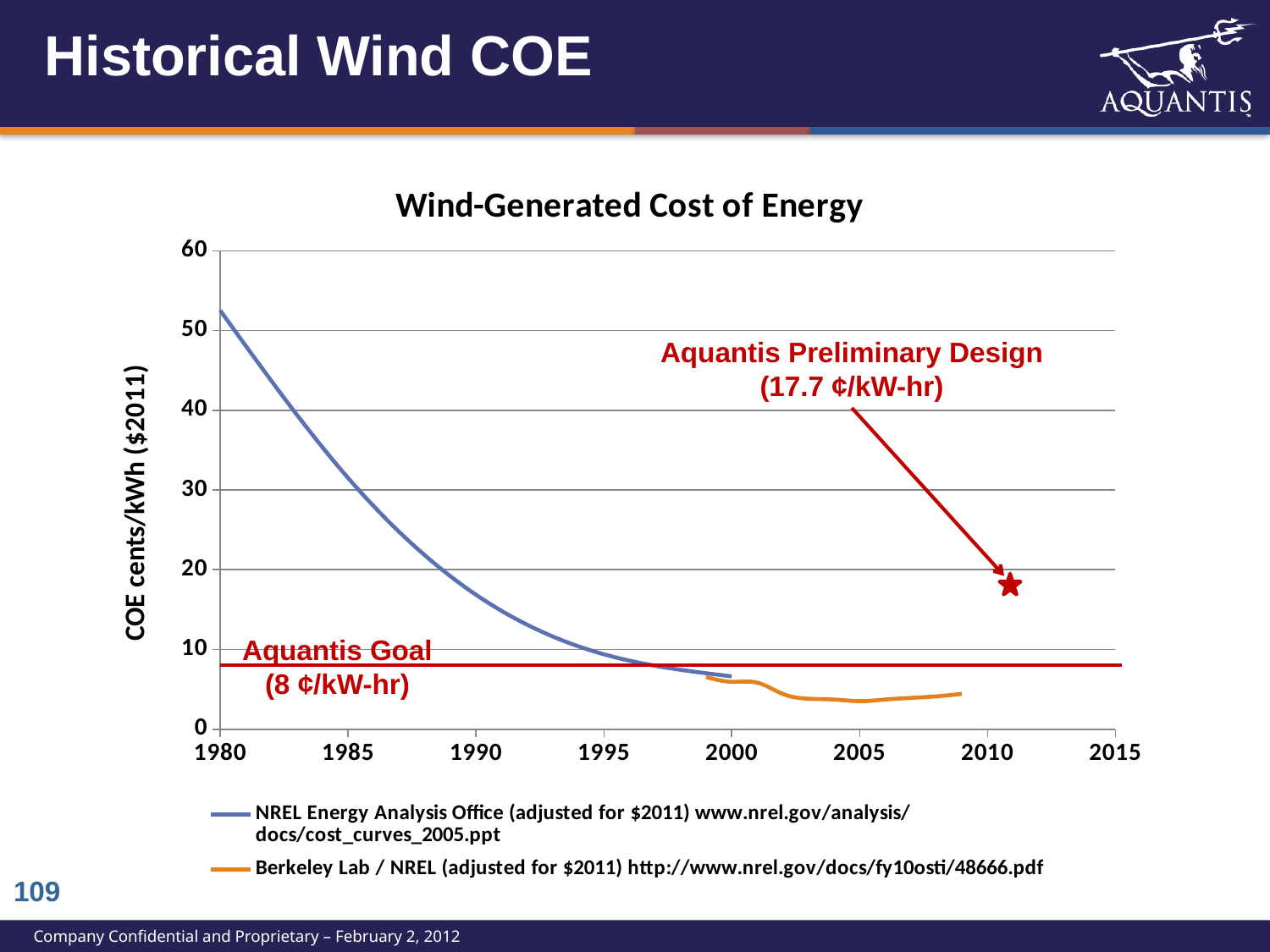
How many series does the chart's legend list? 2 Is the NREL Energy Analysis Office value in 1990 greater or less than 20? less What is the title of the chart? Wind-Generated Cost of Energy Is the Berkeley Lab / NREL value in 2005 greater or less than 10? less Is the NREL Energy Analysis Office value in 1980 greater or less than 50? greater What COE value is given for the Aquantis Goal? 8 ¢/kW-hr Does the NREL Energy Analysis Office series rise or fall from 1980 to 2000? fall Which is larger, the Aquantis Preliminary Design COE or the Aquantis Goal COE? Aquantis Preliminary Design What COE value is given for the Aquantis Preliminary Design? 17.7 ¢/kW-hr What kind of chart is shown on the slide? line chart What is the label of the vertical axis? COE cents/kWh ($2011)